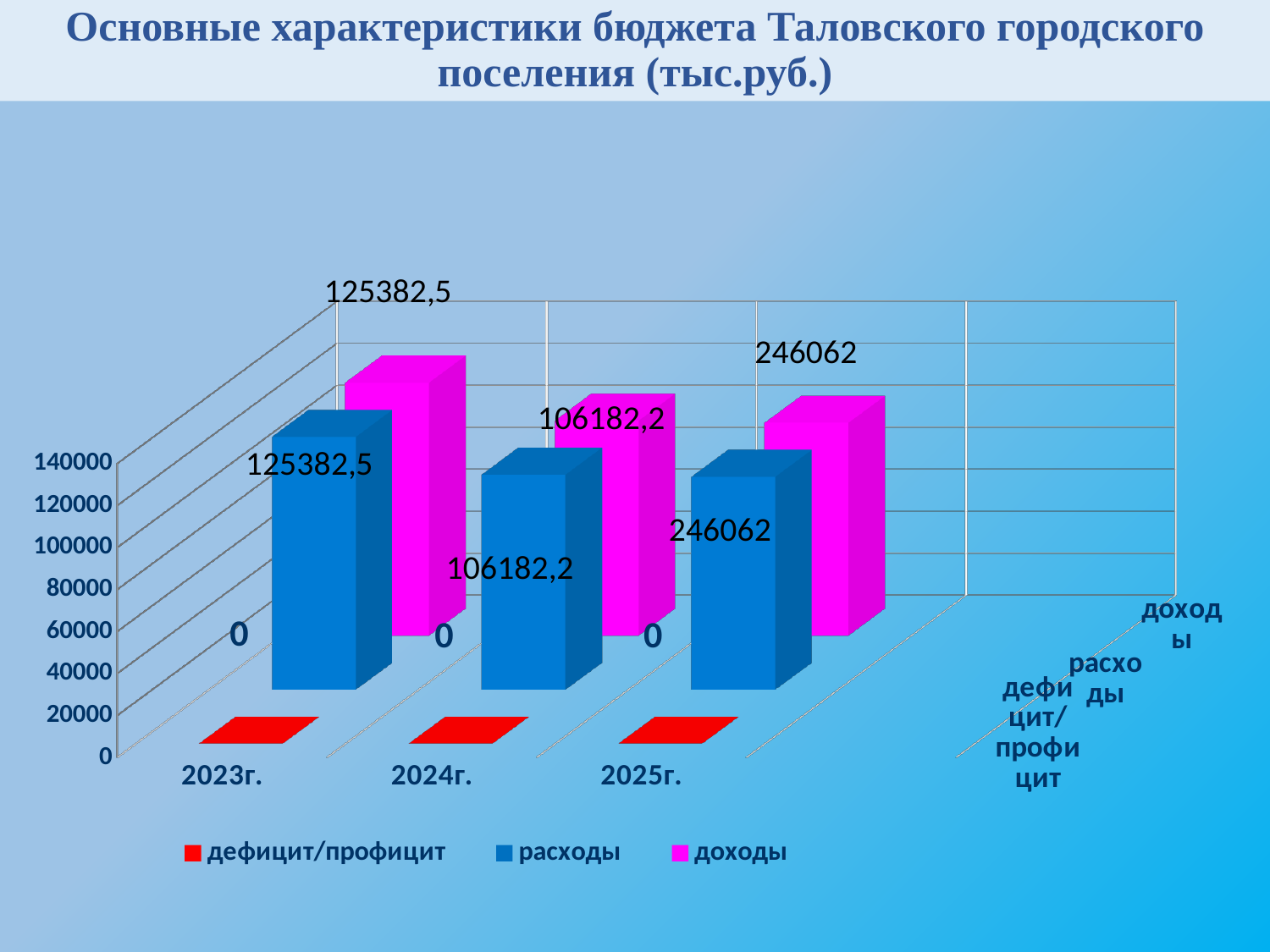
Which is larger: расходы in 2023г. or расходы in 2024г.? расходы in 2023г. What is the value of расходы for 2024г.? 106182,2 Which colour represents the доходы series in the legend? magenta What is the value of доходы for 2025г.? 246062 What is the value of дефицит/профицит for 2024г.? 0 What type of chart is shown on the slide? bar chart How many series does the legend list? 3 What is the difference between доходы in 2025г. and доходы in 2023г.? 120679,5 What is the value of доходы for 2023г.? 125382,5 How many years are shown on the x axis? 3